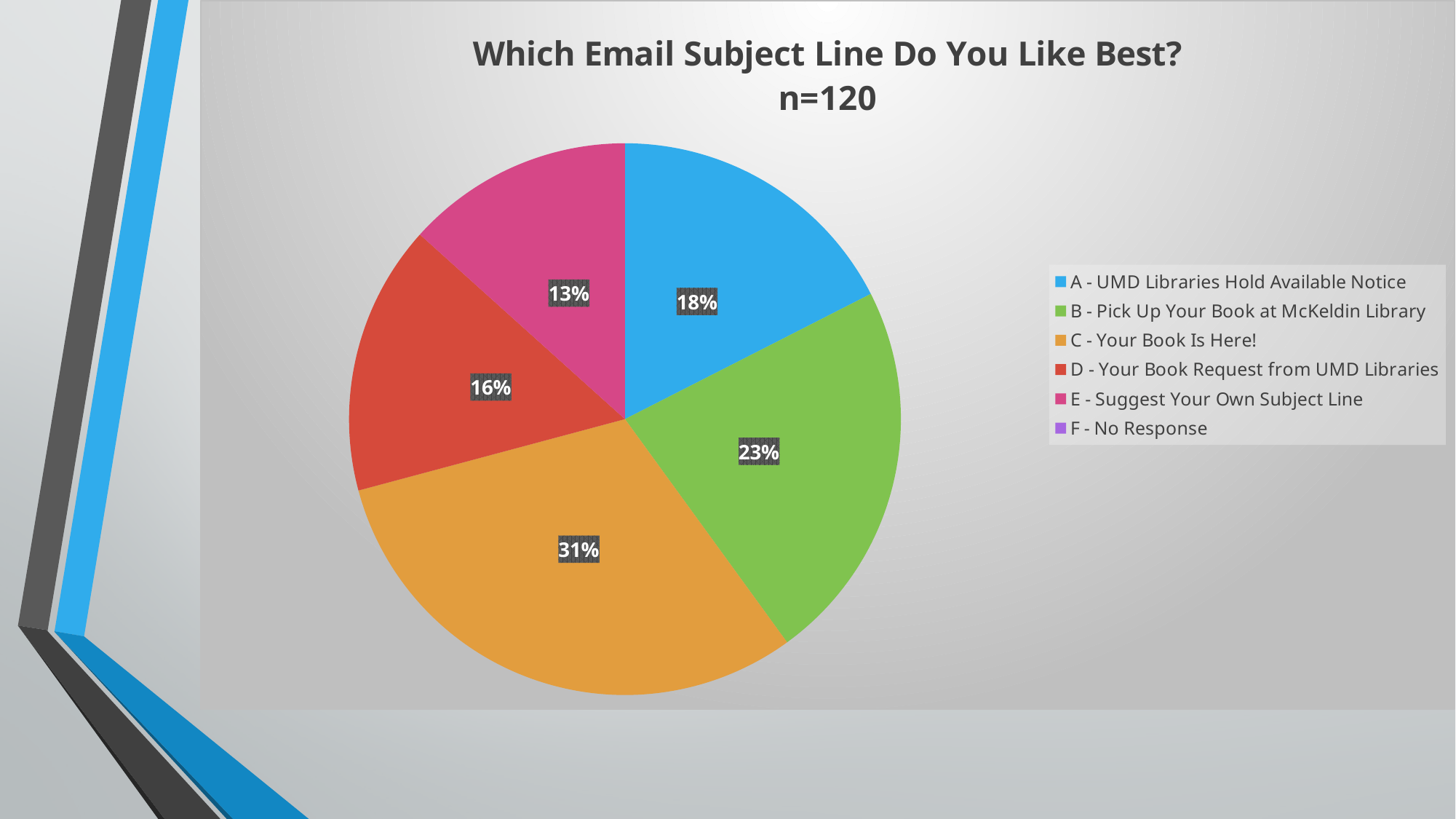
What kind of chart is shown on the slide? pie chart What share of the pie does "A - UMD Libraries Hold Available Notice" have? 18% What share of the pie does "D - Your Book Request from UMD Libraries" have? 16% Which labelled slice has the smallest share of the pie? E - Suggest Your Own Subject Line What is the difference in percentage points between the shares for option C and option B? 8 Which subject line option has the largest share of the pie? C - Your Book Is Here! What share of the pie does "B - Pick Up Your Book at McKeldin Library" have? 23% How many entries does the legend list? 6 What is the title of the chart? Which Email Subject Line Do You Like Best? n=120 Which has the larger share, option A or option D? A - UMD Libraries Hold Available Notice